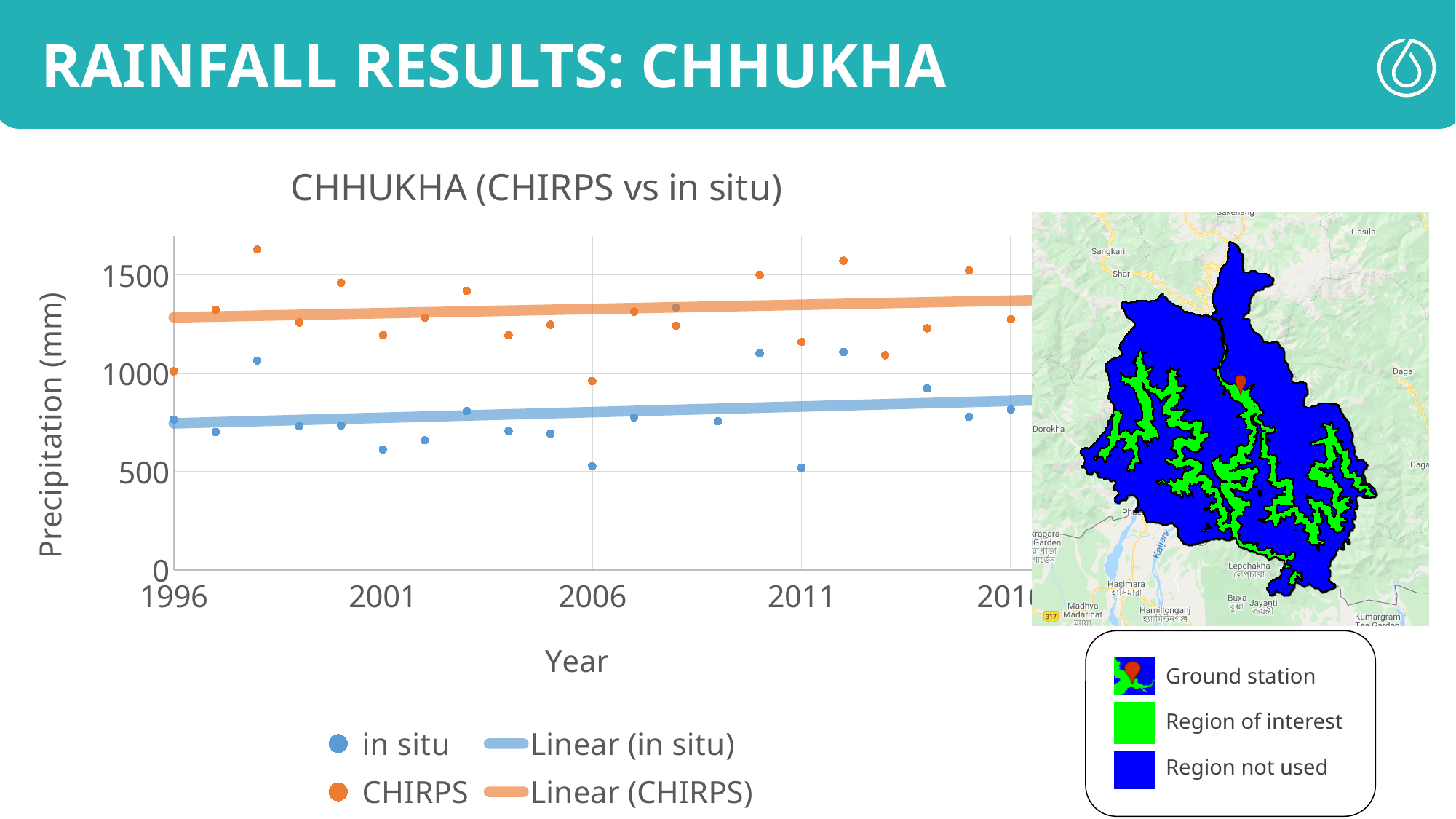
What is the title of the chart? CHHUKHA (CHIRPS vs in situ) Is the in situ value for 1996 greater or less than 1000? less Is the CHIRPS value for 2001 greater or less than 1000? greater Is the in situ value for 1996 greater or less than 500? greater What is the label of the y axis? Precipitation (mm) What kind of chart is shown on the slide? scatter chart Does the Linear (CHIRPS) trend line rise or fall from 1996 to 2016? rise How many entries does the chart legend list? 4 Does the Linear (in situ) trend line rise or fall from 1996 to 2016? rise Which trend line lies higher on the chart, Linear (CHIRPS) or Linear (in situ)? Linear (CHIRPS)